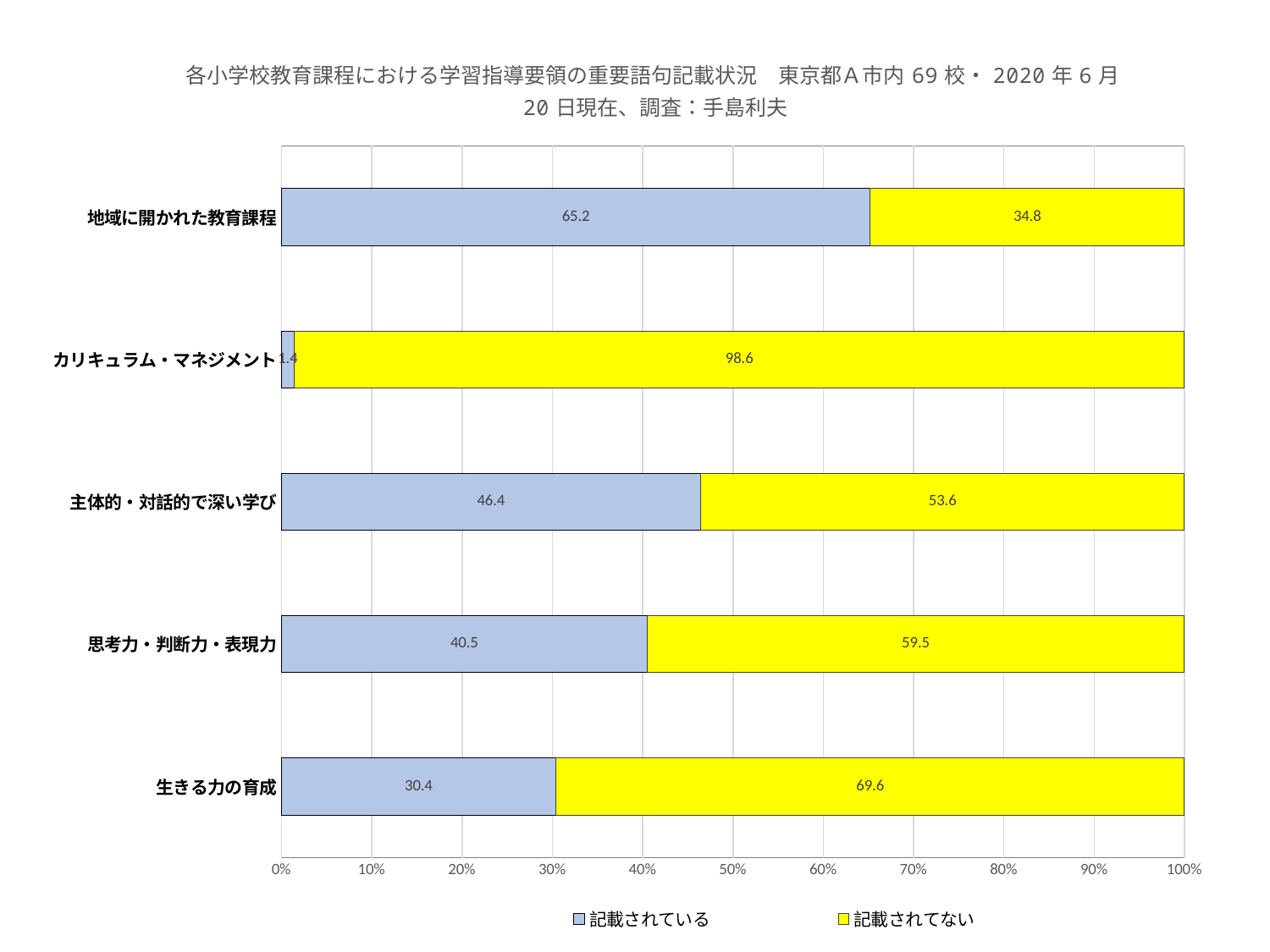
Which is larger: the 記載されている value for 主体的・対話的で深い学び or for 思考力・判断力・表現力? 主体的・対話的で深い学び What is the value of 記載されている for 地域に開かれた教育課程? 65.2 Which category has the highest value for 記載されている? 地域に開かれた教育課程 What is the value of 記載されている for 生きる力の育成? 30.4 What is the difference between the 記載されてない values for 主体的・対話的で深い学び and 地域に開かれた教育課程? 18.8 How many categories are plotted on the chart? 5 What is the value of 記載されてない for 思考力・判断力・表現力? 59.5 How many series does the legend list? 2 Which category has the lowest value for 記載されている? カリキュラム・マネジメント What type of chart is shown on the slide? Stacked bar chart Which legend entry is shown in yellow? 記載されてない What is the value of 記載されてない for カリキュラム・マネジメント? 98.6